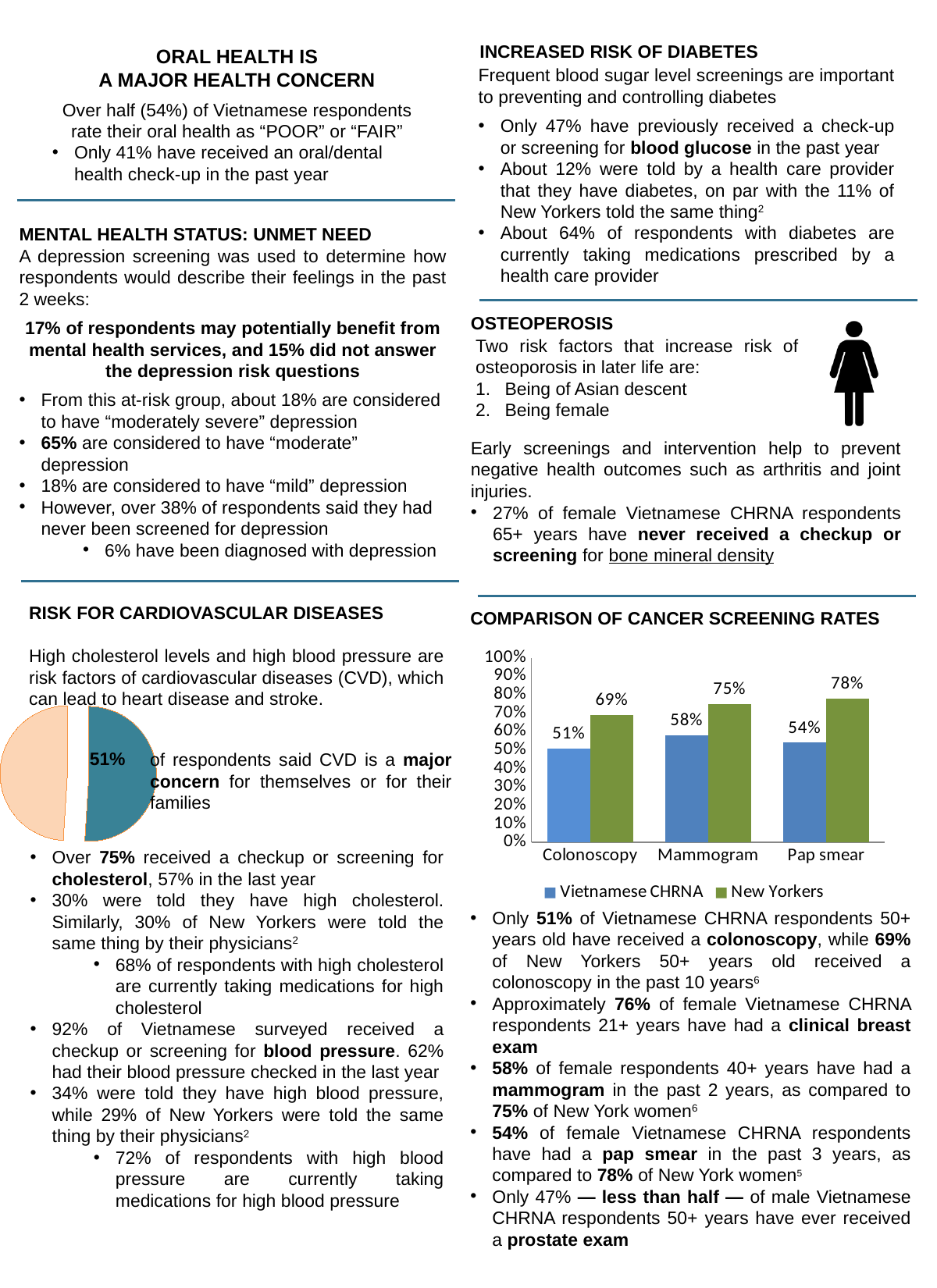
In the Comparison of Cancer Screening Rates chart, which screening has the highest value for Vietnamese CHRNA? Mammogram In the Comparison of Cancer Screening Rates chart, which is larger: Vietnamese CHRNA for Mammogram or New Yorkers for Colonoscopy? New Yorkers for Colonoscopy In the Comparison of Cancer Screening Rates chart, what is the value for Vietnamese CHRNA for Colonoscopy? 51% In the Comparison of Cancer Screening Rates chart, what is the value for New Yorkers for Pap smear? 78% In the Comparison of Cancer Screening Rates chart, what is the difference between New Yorkers and Vietnamese CHRNA for Pap smear? 24% In the Comparison of Cancer Screening Rates chart, how many series does the legend list? 2 What kind of chart is the Comparison of Cancer Screening Rates chart? Bar chart In the Comparison of Cancer Screening Rates chart, which screening has the lowest value for New Yorkers? Colonoscopy In the Comparison of Cancer Screening Rates chart, what is the difference between New Yorkers and Vietnamese CHRNA for Colonoscopy? 18% In the Comparison of Cancer Screening Rates chart, how many screening categories are shown on the x axis? 3 In the Comparison of Cancer Screening Rates chart, what colour are the New Yorkers bars? Green In the Comparison of Cancer Screening Rates chart, what is the value for New Yorkers for Mammogram? 75%